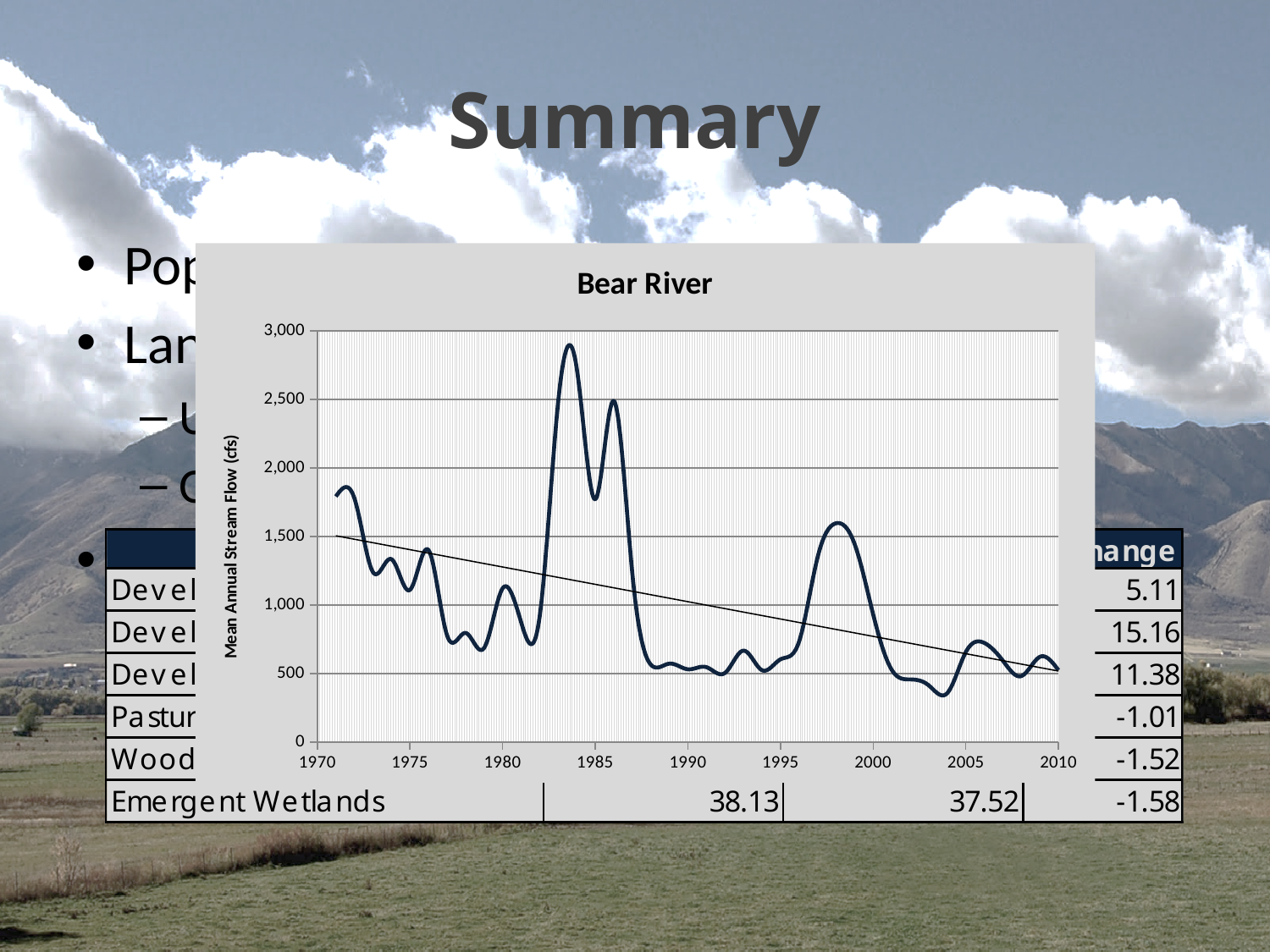
According to the straight trend line on the Bear River chart, do values generally rise or fall from 1970 to 2010? fall What is the highest tick value shown on the y axis of the Bear River chart? 3,000 On the Bear River chart, which is larger: the peak around 1984 or the peak around 1998? the peak around 1984 What is the label of the y axis of the Bear River chart? Mean Annual Stream Flow (cfs) Is the value for 1986 on the Bear River chart greater or less than 2,000? greater Is the value for 1990 on the Bear River chart greater or less than 1,000? less Is the value for 1998 on the Bear River chart greater or less than 1,000? greater What is the title of the chart? Bear River What kind of chart is shown on the slide? line chart